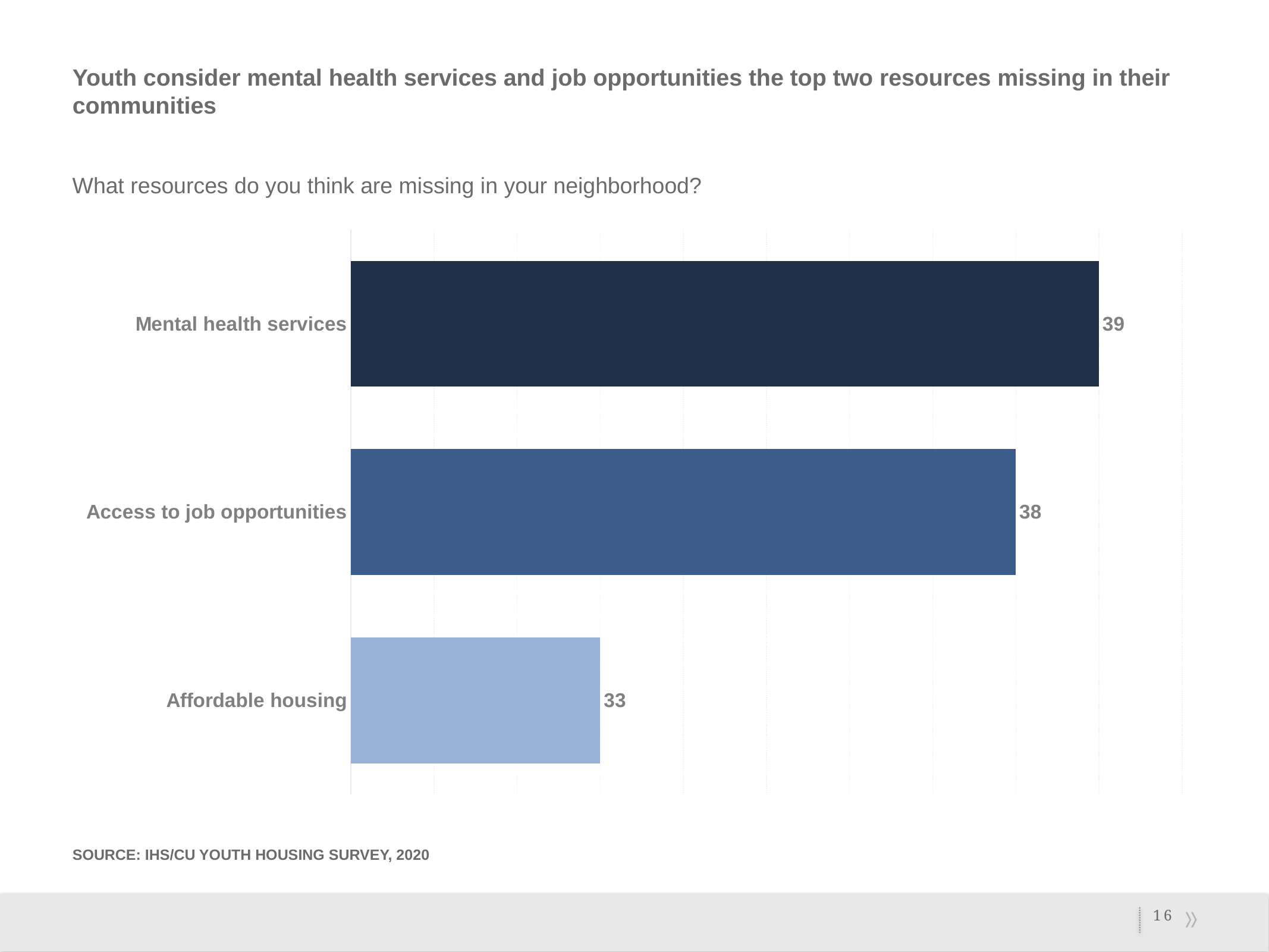
Which is larger, the value for Access to job opportunities or the value for Affordable housing? Access to job opportunities What is the value for Mental health services? 39 Which category has the highest value? Mental health services What is the value for Access to job opportunities? 38 What is the difference between the values for Mental health services and Affordable housing? 6 What is the value for Affordable housing? 33 What survey question is the chart based on, as shown above the chart? What resources do you think are missing in your neighborhood? How many categories are shown in the chart? 3 What kind of chart is shown on the slide? Bar chart What is the source cited for the chart? IHS/CU YOUTH HOUSING SURVEY, 2020 Which category has the lowest value? Affordable housing What is the difference between the values for Access to job opportunities and Affordable housing? 5